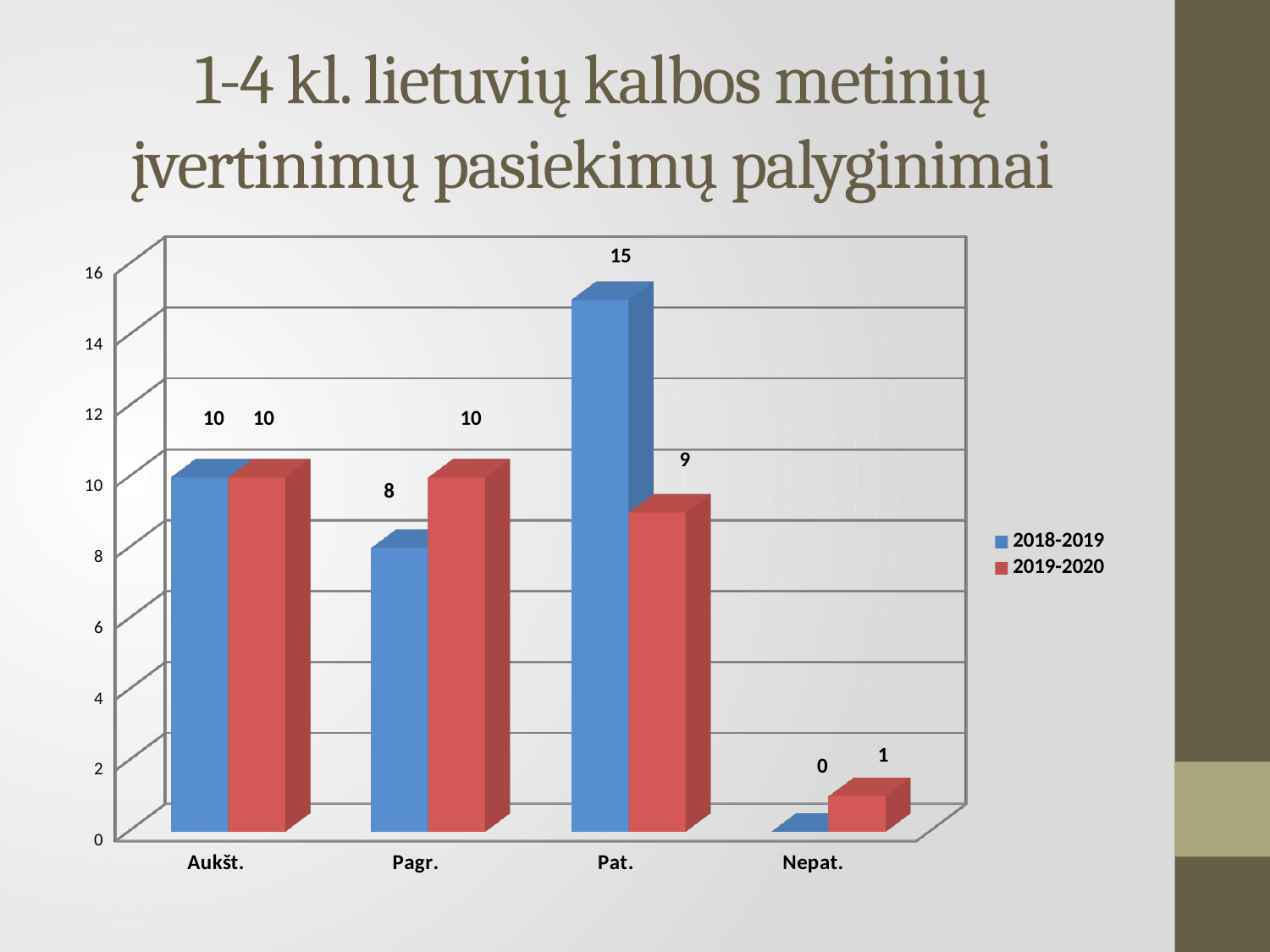
How many categories are shown on the x axis? 4 What kind of chart is shown on the slide? bar chart Which category has the lowest value in the 2019-2020 series? Nepat. What is the difference between the 2019-2020 values for Aukšt. and Nepat.? 9 Which colour represents the 2019-2020 series? red How many series does the legend list? 2 What is the difference between the 2018-2019 and 2019-2020 values for Pat.? 6 What is the value for Pat. in the 2018-2019 series? 15 What is the value for Pagr. in the 2019-2020 series? 10 For Pagr., which series has the larger value, 2018-2019 or 2019-2020? 2019-2020 What is the value for Nepat. in the 2018-2019 series? 0 Which category has the highest value in the 2018-2019 series? Pat.